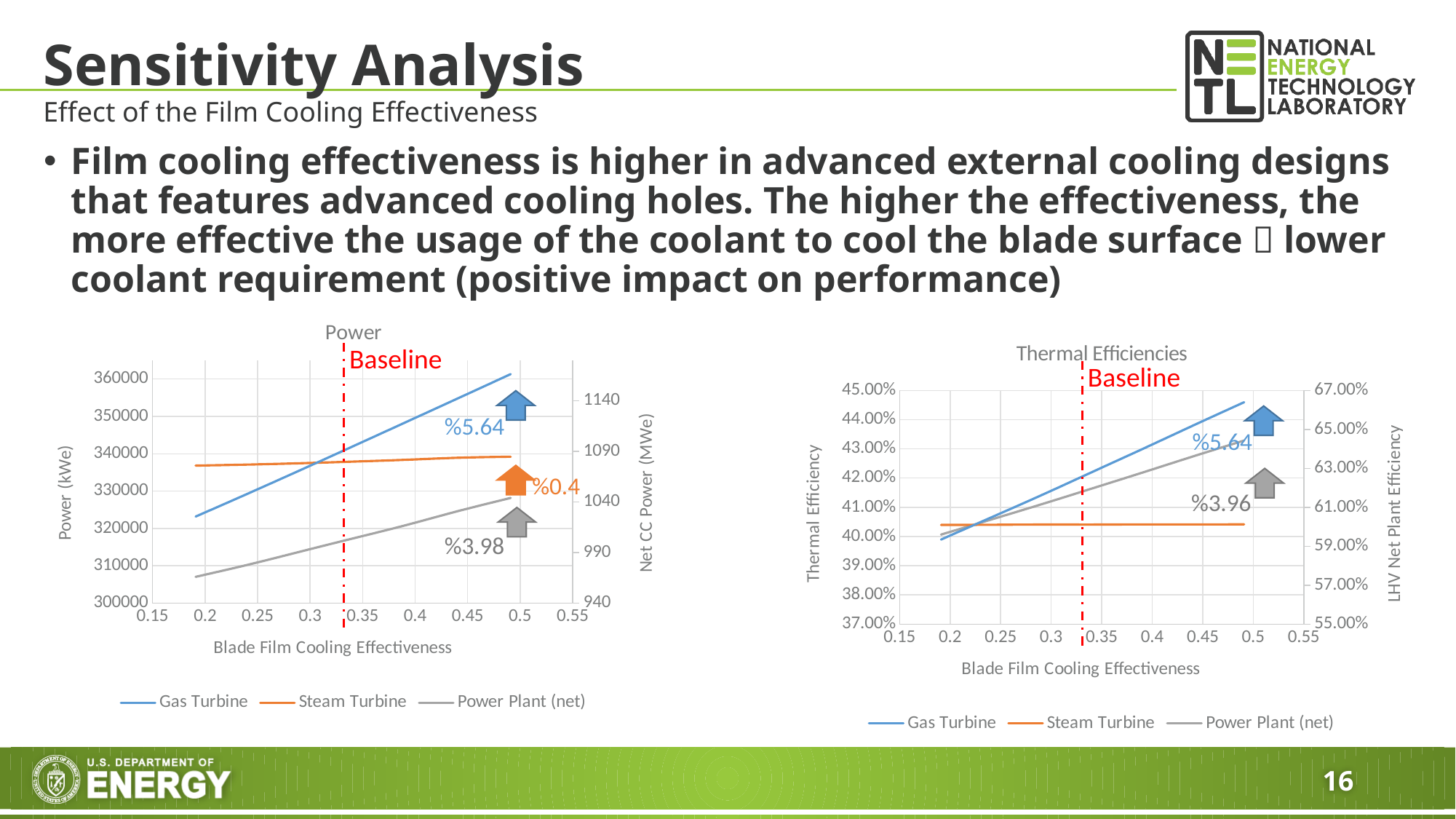
On the Thermal Efficiencies chart, what percentage change is annotated next to the grey arrow for the Power Plant (net)? %3.96 How many series does the legend of the Thermal Efficiencies chart list? 3 On the Power chart, is the Steam Turbine value at 0.2 greater or less than 330000? greater On the Thermal Efficiencies chart, is the Steam Turbine value at 0.5 greater or less than 42.00%? less On the Power chart, does the Gas Turbine line rise or fall as Blade Film Cooling Effectiveness increases? rise On the Thermal Efficiencies chart, does the Gas Turbine line rise or fall as Blade Film Cooling Effectiveness increases? rise On the Power chart, is the Gas Turbine value at 0.5 greater or less than 350000? greater What kind of chart is the Power chart? line chart On the Power chart, which is larger at 0.2: Gas Turbine or Steam Turbine? Steam Turbine On the Power chart, what percentage change is annotated next to the blue arrow for the Gas Turbine? %5.64 On the Power chart, which is larger at 0.5: Gas Turbine or Steam Turbine? Gas Turbine